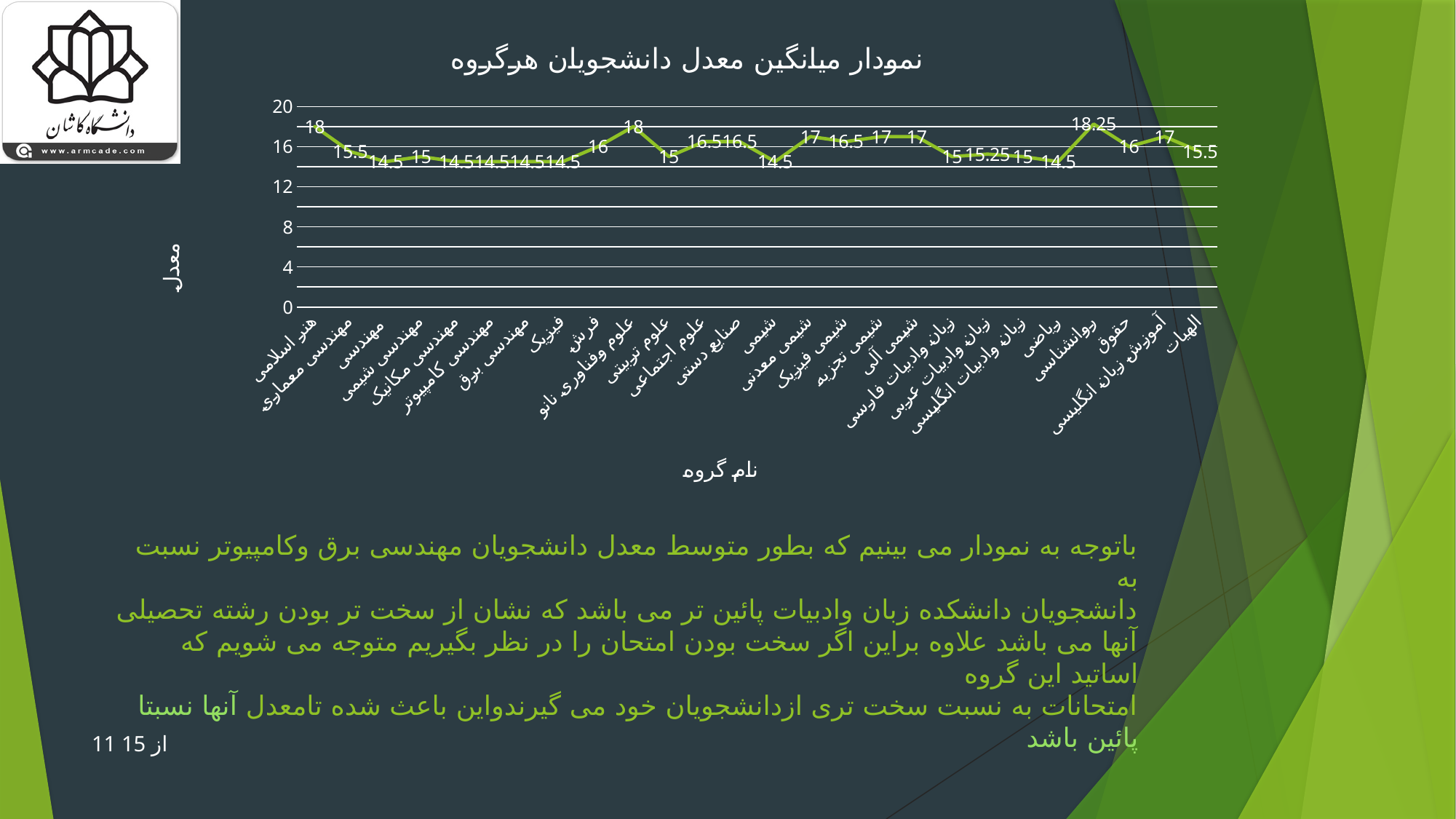
Is the value for هنر اسلامی greater or less than 16? greater What is the value for علوم وفناوری نانو? 18 Which group has the highest value on the chart? روانشناسی Which is larger, the value for روانشناسی or the value for هنر اسلامی? روانشناسی What is the value for هنر اسلامی? 18 What is the value for روانشناسی? 18.25 What is the difference between the values for هنر اسلامی and الهیات? 2.5 What is the value for الهیات? 15.5 What is the title of the chart? نمودار میانگین معدل دانشجویان هرگروه How many groups are plotted on the x axis of the chart? 26 What is the label on the vertical axis of the chart? معدل What type of chart is shown on the slide? Line chart